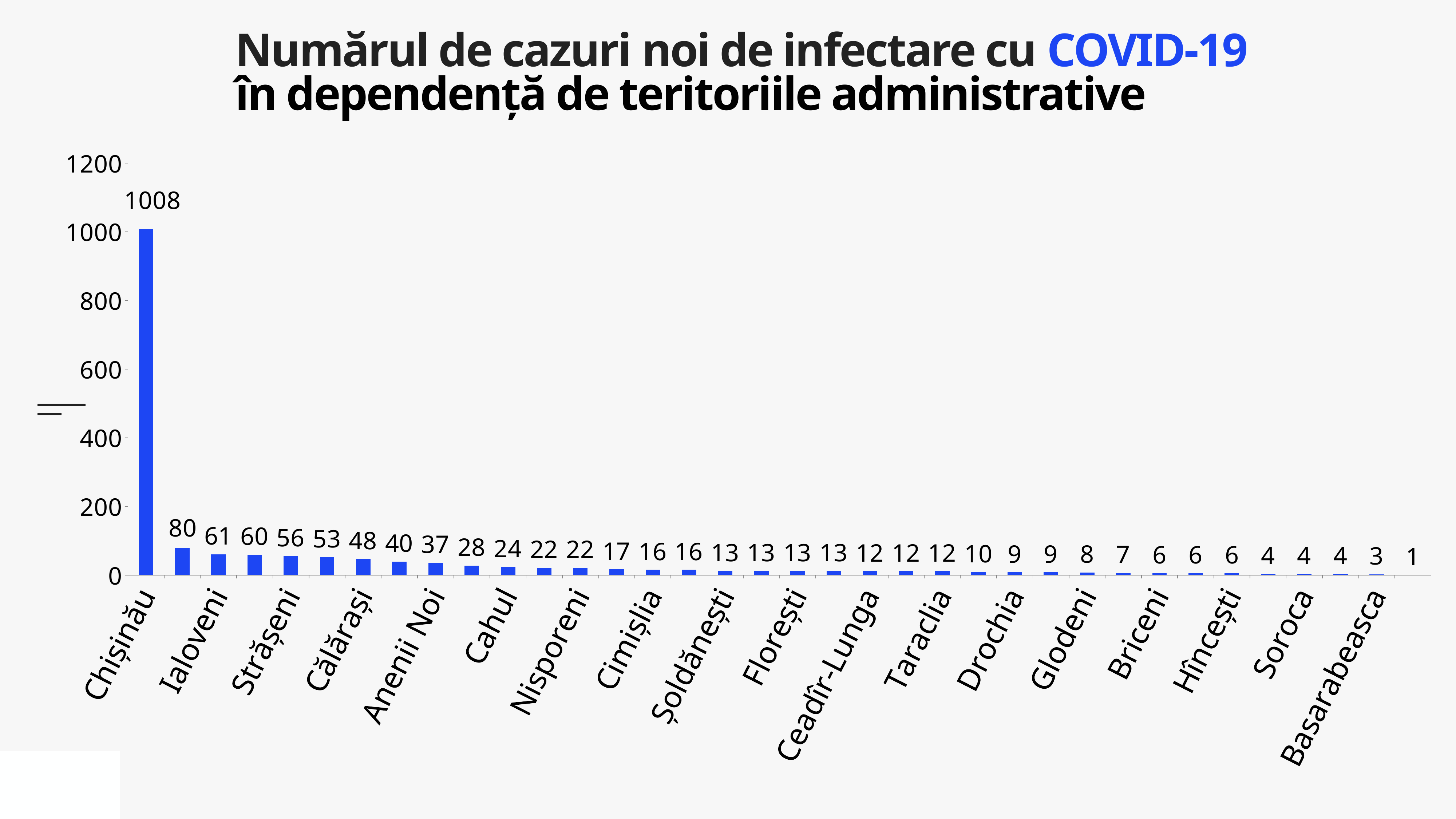
Which has more new cases, Chișinău or Ialoveni? Chișinău Is the value for Basarabeasca greater or less than 200? less Which territory has the highest number of new COVID-19 cases? Chișinău What is the number of new cases for Chișinău? 1008 What is the difference between the highest value (1008) and the second-highest value (80)? 928 What is the smallest value labelled on any bar in the chart? 1 What is the highest tick value shown on the vertical axis? 1200 What kind of chart is shown on the slide? bar chart Do the values rise or fall from left to right along the x axis? fall What colour are the bars in the chart? blue What is the second-highest value labelled in the chart? 80 Is the value for Chișinău greater or less than 1000? greater